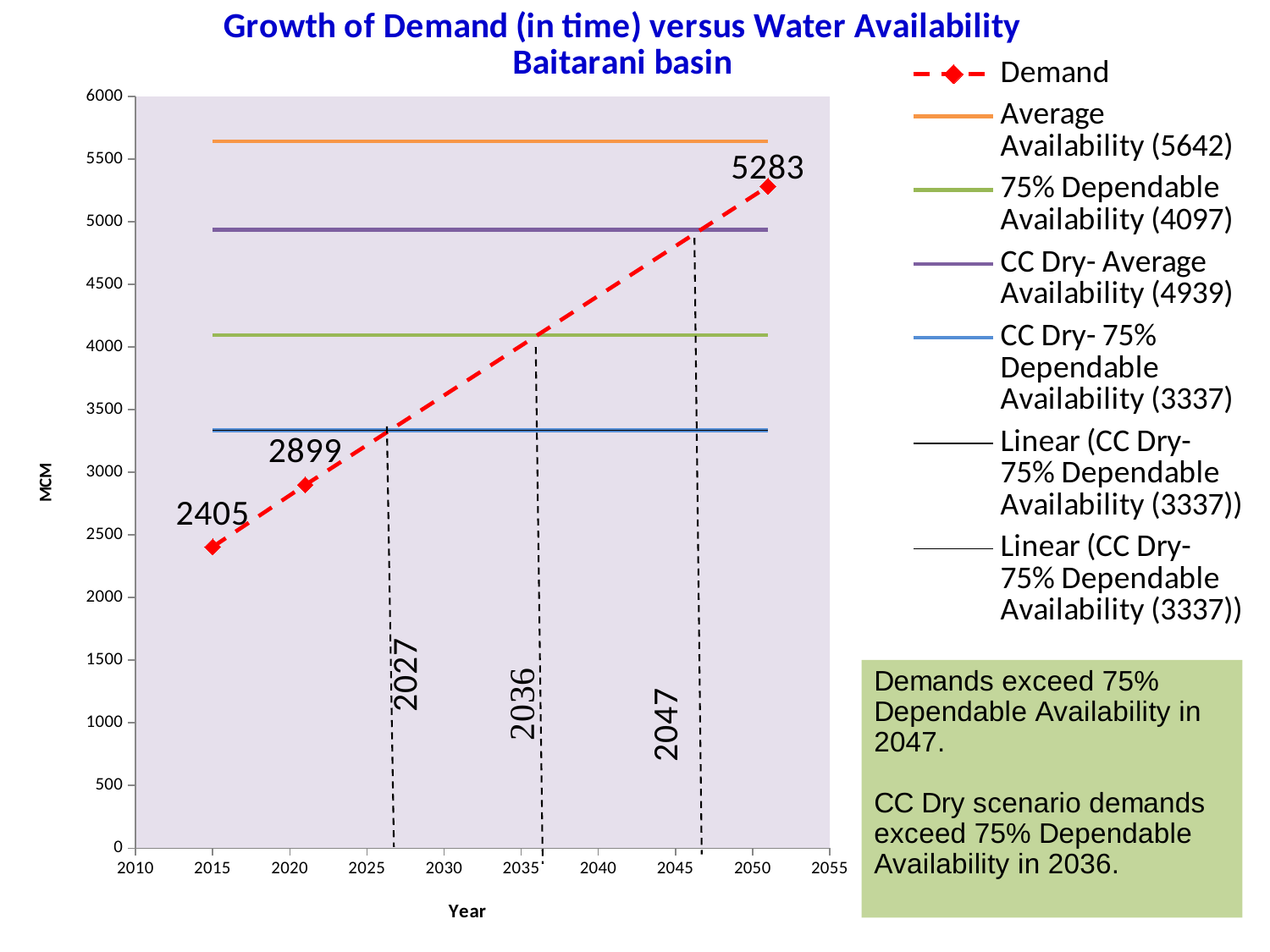
What is the demand value labelled at the first point of the Demand series (2015)? 2405 Which availability line has the highest value? Average Availability (5642) According to the legend, what is the CC Dry- 75% Dependable Availability value? 3337 Does the Demand series rise or fall over the years? Rise Which availability line has the lowest value? CC Dry- 75% Dependable Availability (3337) What is the difference between the last labelled demand value (5283) and the first labelled demand value (2405)? 2878 What kind of chart is shown on the slide? Line chart According to the legend, what is the Average Availability value? 5642 Which is larger, Average Availability or CC Dry- Average Availability? Average Availability What is the demand value labelled at the last point of the Demand series? 5283 How many entries does the legend list? 7 What is the difference between Average Availability (5642) and 75% Dependable Availability (4097)? 1545